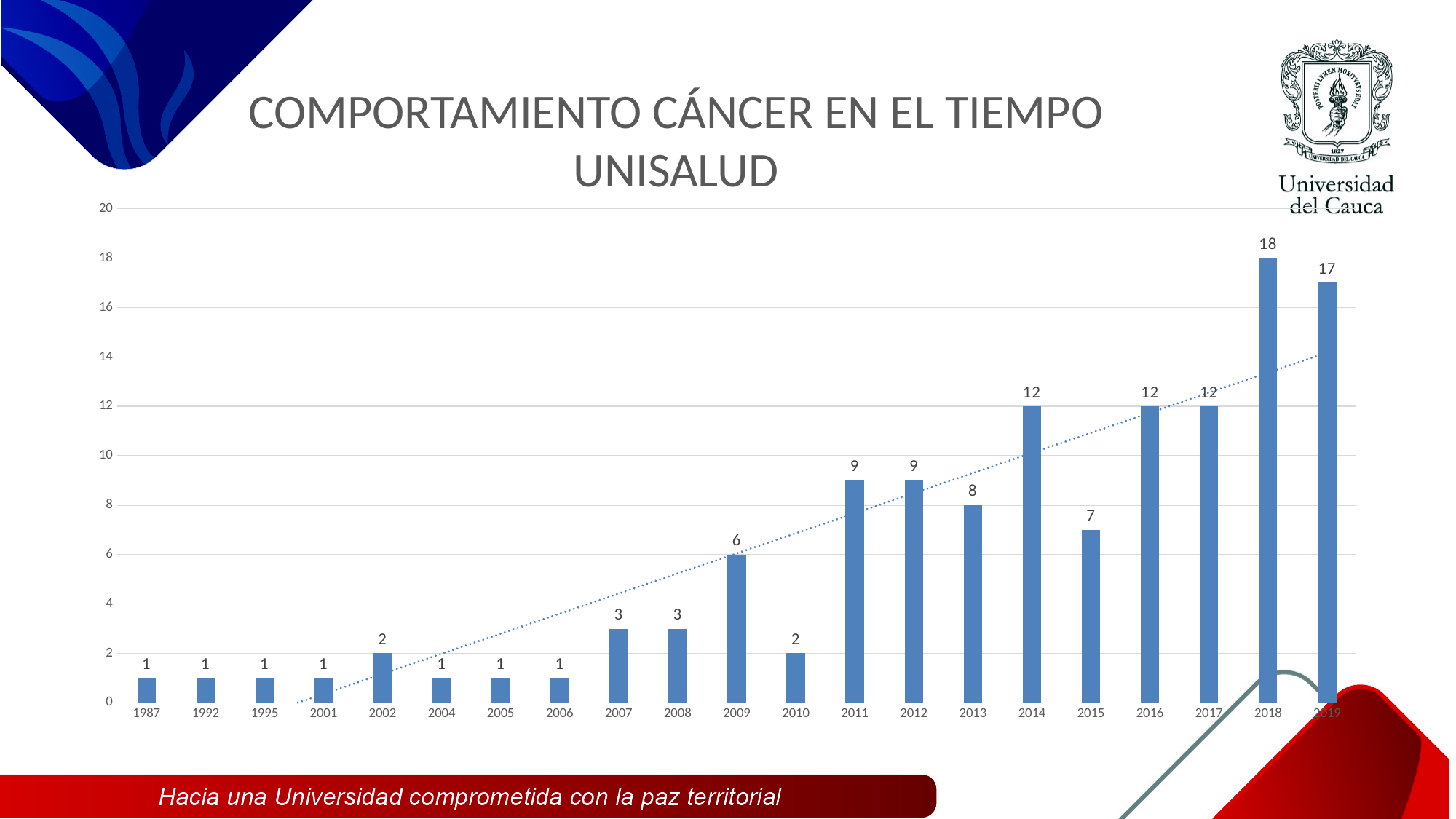
Is the value for 2019 greater or less than 10? greater What is the difference between the values for 2014 and 2013? 4 What kind of chart is this? bar chart How many years are shown on the x axis? 21 What is the value for 2015? 7 Which year has the highest value? 2018 Do the values generally rise or fall from 1987 to 2019? rise What is the title of the chart? COMPORTAMIENTO CÁNCER EN EL TIEMPO UNISALUD Which is larger, the value for 2011 or the value for 2010? 2011 What is the value for 2009? 6 What is the difference between the values for 2018 and 2019? 1 What is the value for 2018? 18